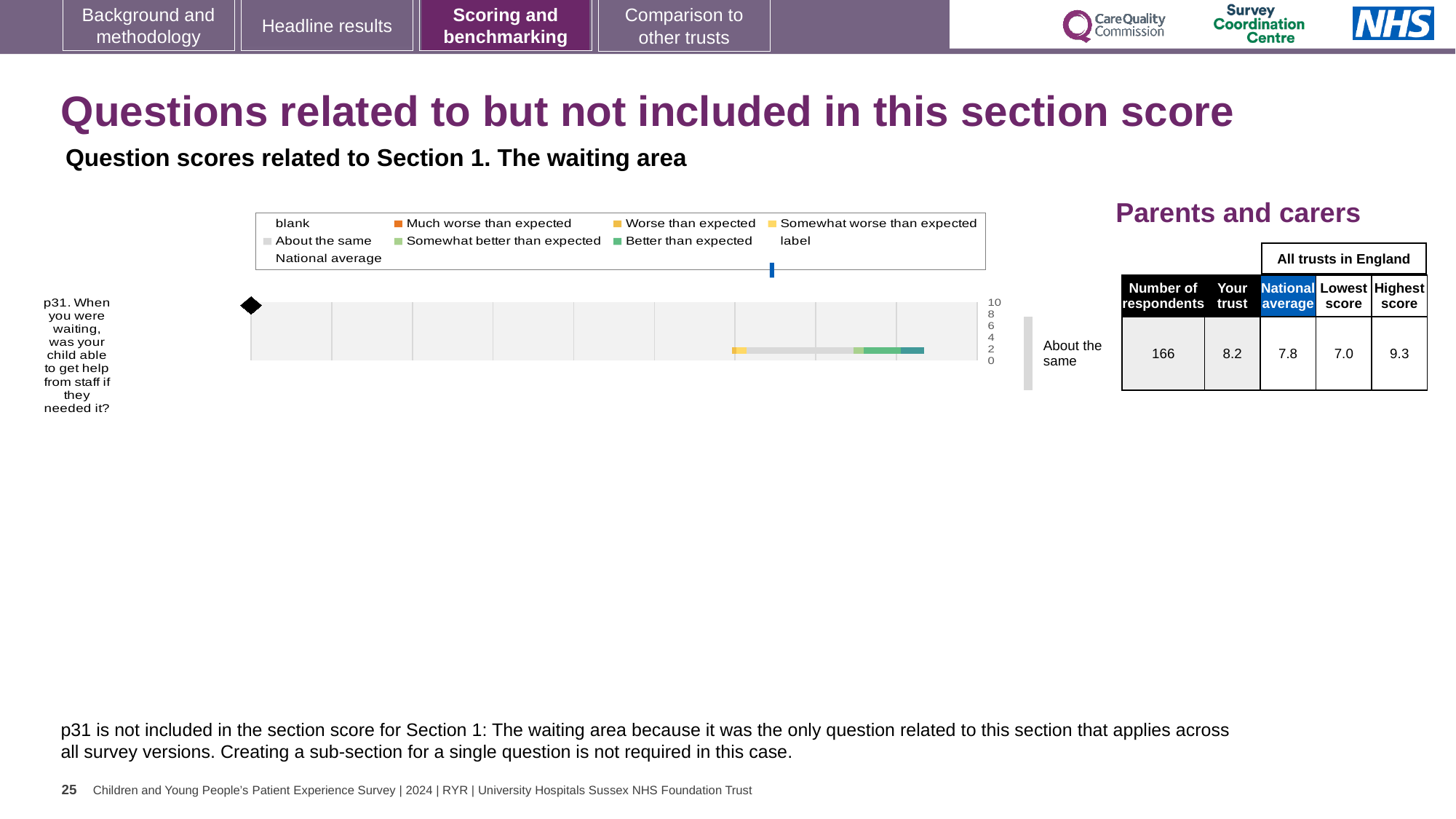
What is the difference between the highest score and the lowest score for p31? 2.3 What is the difference between the trust's score and the national average for p31? 0.4 Is the trust's score for p31 higher or lower than the national average? higher What benchmark category is the trust's result for p31 placed in, as labelled to the right of the chart? About the same What is the maximum value shown on the chart's score axis? 10 How many questions are plotted in the chart? 1 What kind of chart is shown for question p31? bar chart What is the lowest score among all trusts in England for p31? 7.0 How many respondents answered question p31? 166 What is the national average score for p31? 7.8 What is the 'Your trust' score for p31 shown in the table next to the chart? 8.2 What is the highest score among all trusts in England for p31? 9.3